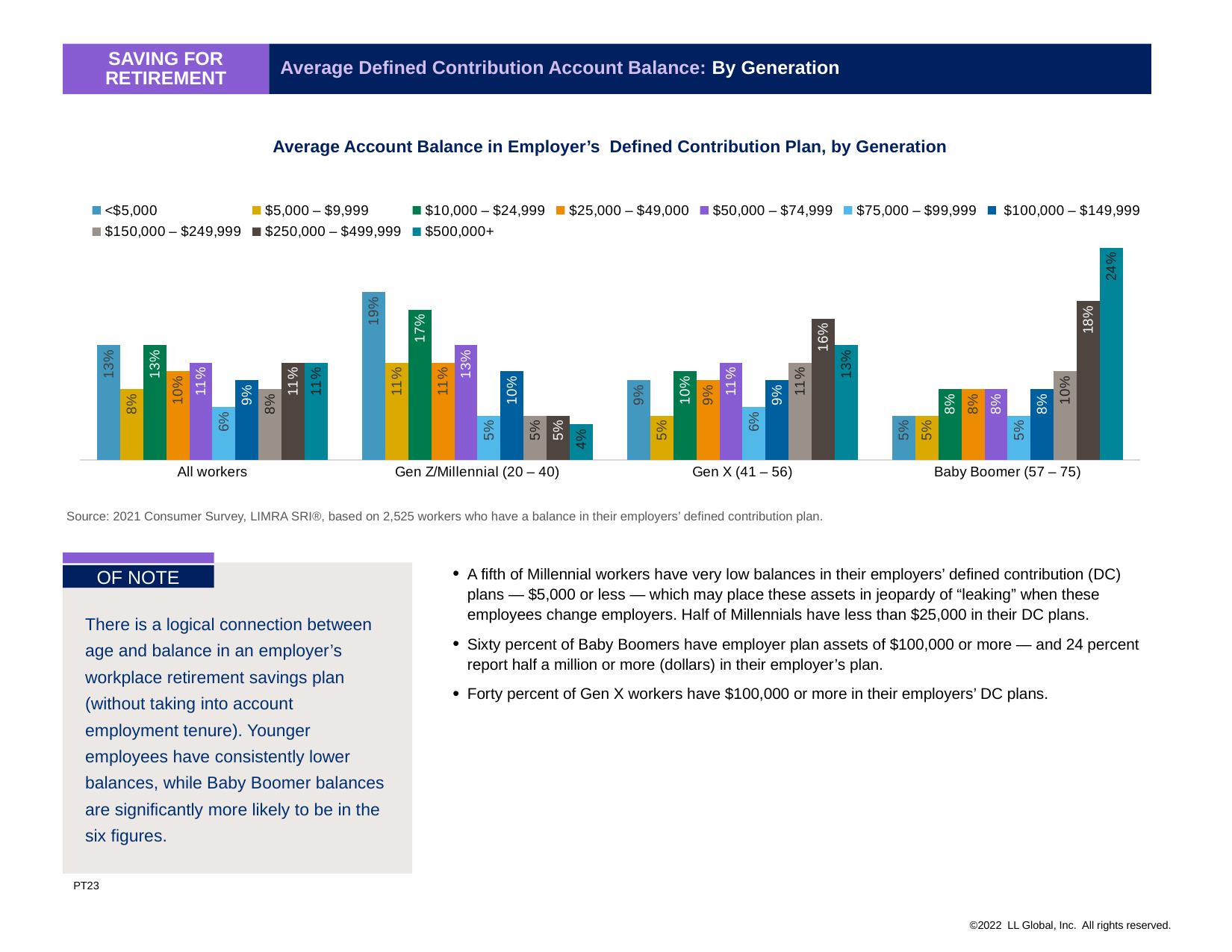
How many generation categories are shown on the x axis? 4 What is the difference between the <$5,000 percentage for Gen Z/Millennial (20 – 40) and for Baby Boomer (57 – 75)? 14% What percentage of Gen Z/Millennial (20 – 40) workers have a balance of <$5,000? 19% Which balance range has the lowest percentage among Gen Z/Millennial (20 – 40) workers? $500,000+ How many balance ranges does the legend list? 10 What percentage of Baby Boomers (57 – 75) have a balance of $500,000+? 24% Which is larger: the $500,000+ percentage for Gen X (41 – 56) or for Gen Z/Millennial (20 – 40)? Gen X (41 – 56) What is the title of the chart? Average Account Balance in Employer's Defined Contribution Plan, by Generation What percentage of All workers have a balance of $75,000 – $99,999? 6% What percentage of Gen X (41 – 56) workers have a balance of $250,000 – $499,999? 16% What type of chart is shown? Bar chart Which balance range has the highest percentage among Baby Boomers (57 – 75)? $500,000+